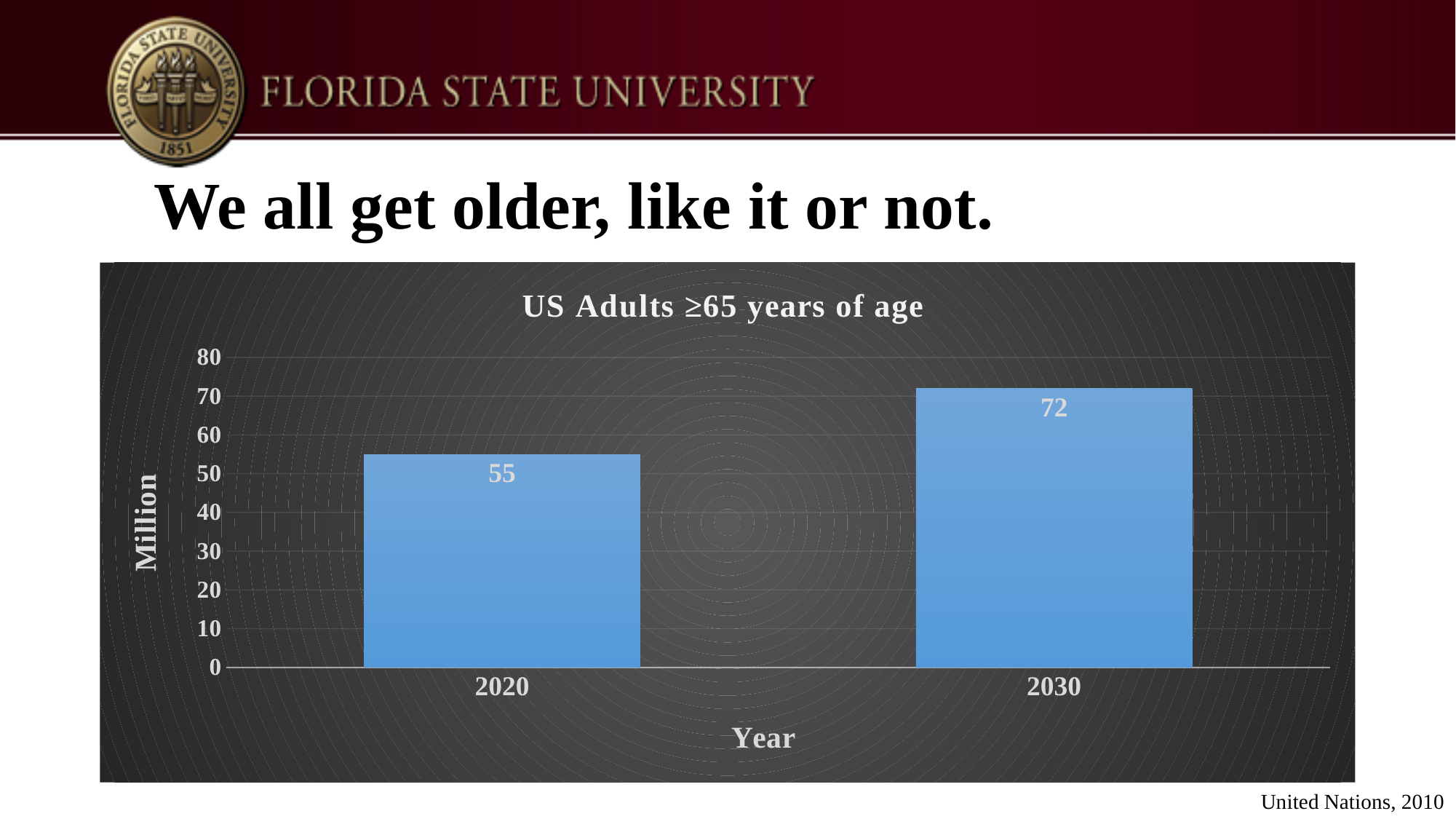
Is the value for 2020 greater or less than 60? less Do the values rise or fall from 2020 to 2030? Rise What is the difference between the values for 2030 and 2020? 17 How many years are shown on the x axis? 2 Which year has the lower value? 2020 What is the value for 2030? 72 What is the value for 2020? 55 What is the title of the chart? US Adults ≥65 years of age What kind of chart is shown? Bar chart Which year has the higher value? 2030 Is the value for 2030 greater or less than 70? greater Is the value for 2030 larger than the value for 2020? Yes